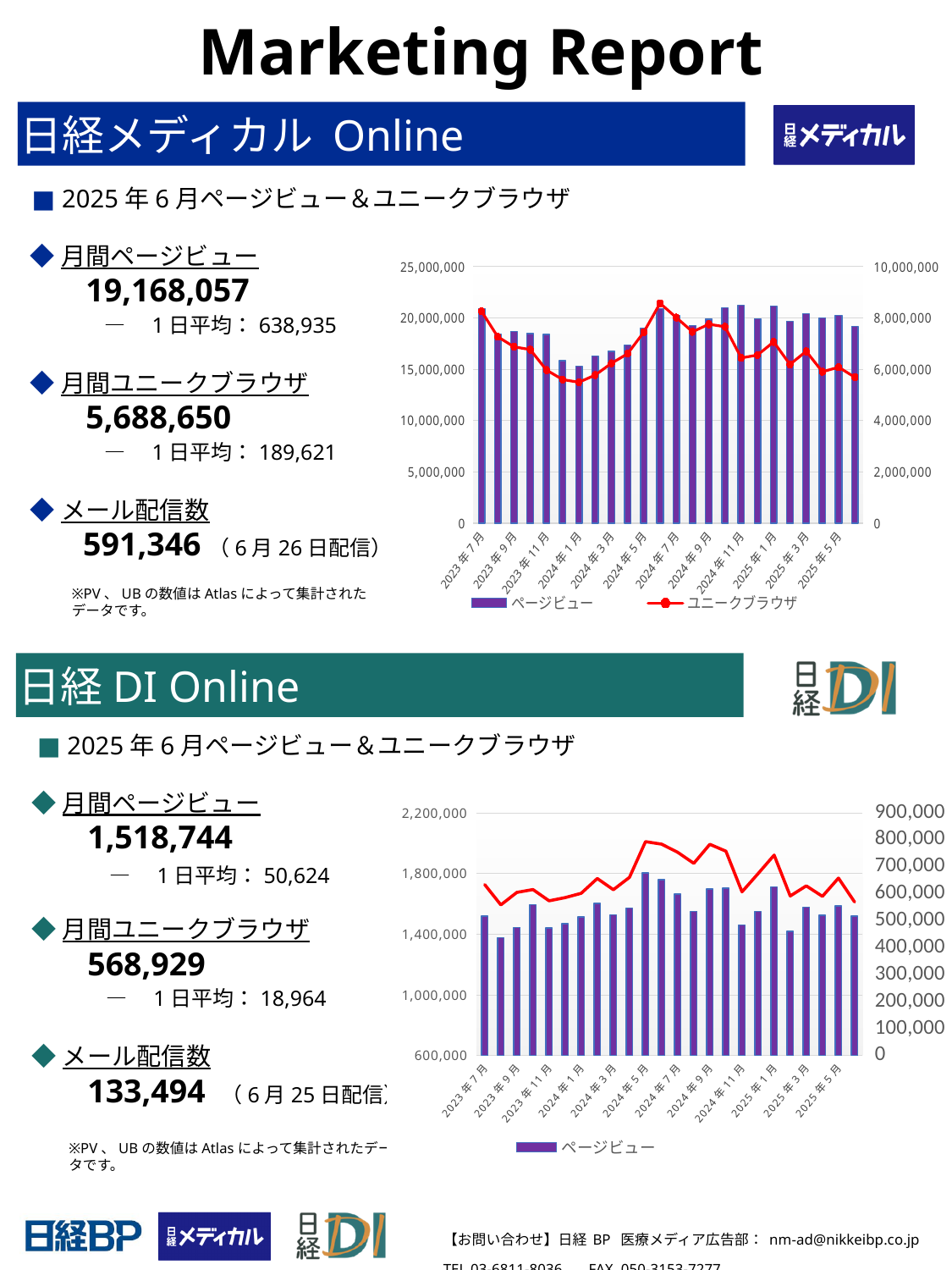
In the bottom chart (日経DI Online), is the ページビュー bar for 2023年9月 greater or less than 1,800,000? less In the top chart (日経メディカル Online), what kind of chart is used to show the data? bar and line chart In the bottom chart (日経DI Online), how many series does the legend list? 1 In the top chart (日経メディカル Online), how many series does the legend list? 2 In the top chart (日経メディカル Online), does the ユニークブラウザ line generally rise or fall from 2024年7月 to 2025年5月? fall In the bottom chart (日経DI Online), is the ページビュー bar for 2024年5月 greater or less than 1,400,000? greater In the top chart (日経メディカル Online), is the ページビュー bar for 2024年1月 greater or less than 20,000,000? less In the top chart (日経メディカル Online), how many month labels are shown on the x axis? 12 In the top chart (日経メディカル Online), what is the highest value shown on the left axis? 25,000,000 In the top chart (日経メディカル Online), what are the two legend entries? ページビュー and ユニークブラウザ